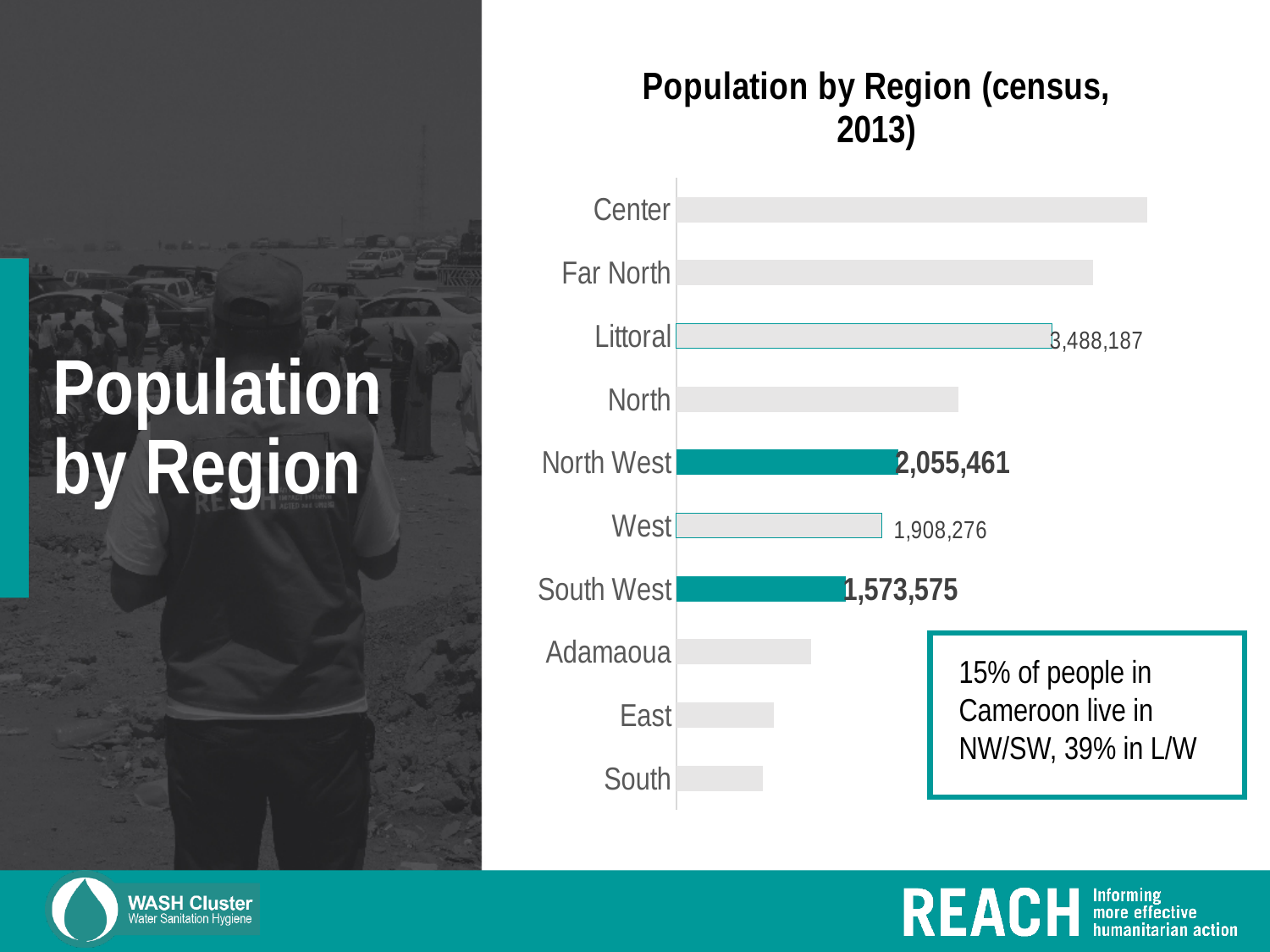
What is the population shown for North West? 2,055,461 Which region has the highest population in the chart? Center Which region has the larger population, North or West? North What is the difference between the populations of North West and South West? 481,886 What is the population shown for Littoral? 3,488,187 What kind of chart is shown on the slide? Bar chart Which region has the larger population, Center or Far North? Center How many regions are shown in the chart? 10 What is the population shown for West? 1,908,276 What is the difference between the populations of Littoral and West? 1,579,911 What is the population shown for South West? 1,573,575 Which two regions' bars are highlighted in solid teal? North West and South West